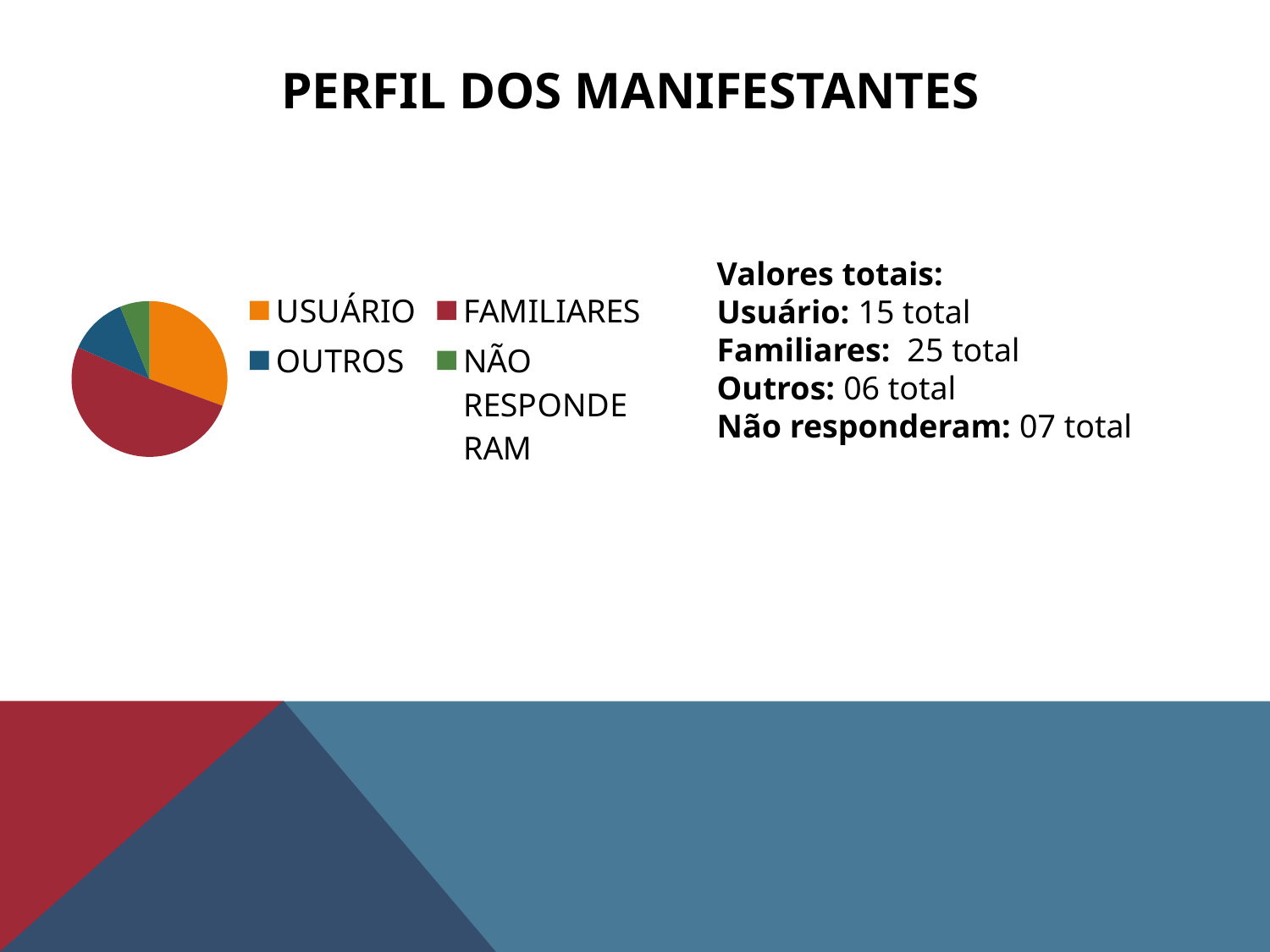
What is the total value for Usuário? 15 What is the combined total of all four categories? 53 What is the total value for Não responderam? 07 Which category has the largest slice of the pie chart? FAMILIARES What is the total value for Familiares? 25 Which category has the smallest slice of the pie chart? NÃO RESPONDERAM What is the total value for Outros? 06 What kind of chart is shown on the slide? pie chart What is the difference between the Familiares total and the Usuário total? 10 How many categories does the pie chart's legend list? 4 What colour represents FAMILIARES in the pie chart? red Which is larger, the Usuário total or the Familiares total? Familiares